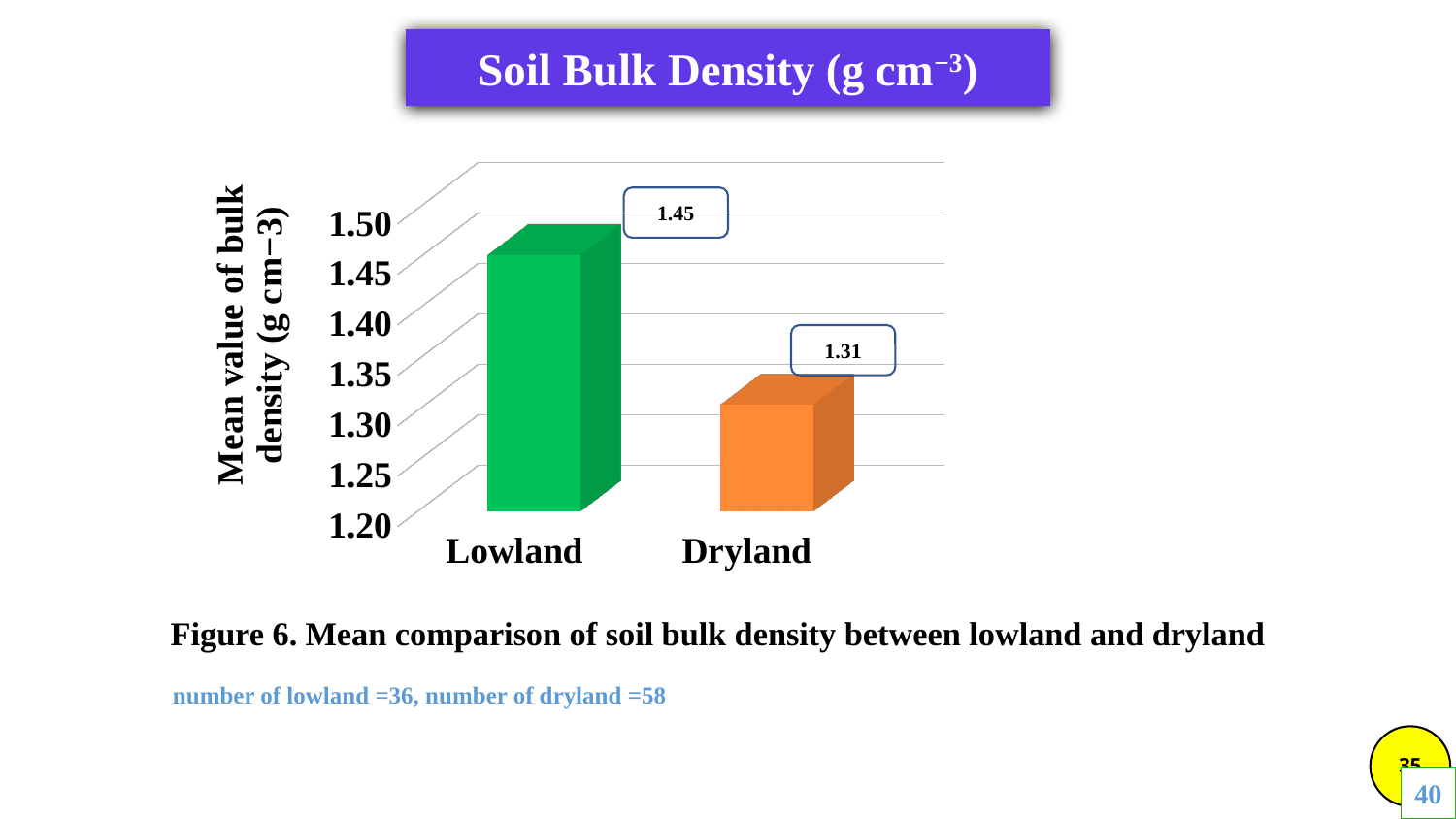
What is the mean soil bulk density value for Lowland? 1.45 Is the value for Lowland greater or less than 1.40? greater Is the value for Lowland larger or smaller than the value for Dryland? larger What is the mean soil bulk density value for Dryland? 1.31 What kind of chart is shown on the slide? bar chart What is the label of the vertical axis of the chart? Mean value of bulk density (g cm−3) What colour is the bar for Dryland? orange Which category has the higher mean soil bulk density? Lowland Is the value for Dryland greater or less than 1.40? less How many categories are shown on the x axis of the chart? 2 What is the difference between the Lowland and Dryland mean bulk density values? 0.15 Which category has the lower mean soil bulk density? Dryland